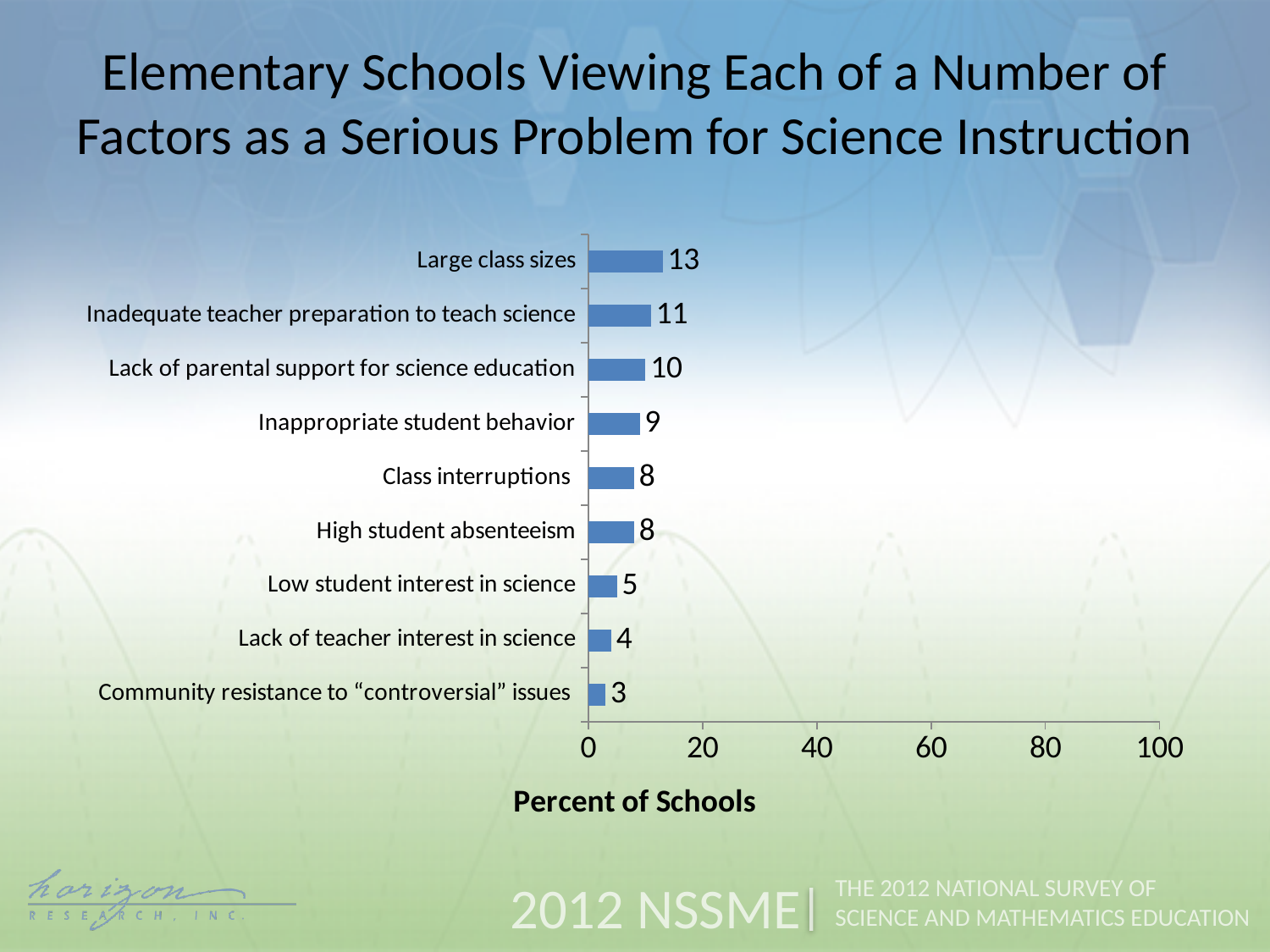
Which factor has the lowest percent of schools viewing it as a serious problem? Community resistance to "controversial" issues What is the value for 'Lack of teacher interest in science'? 4 What is the difference between the values for 'Large class sizes' and 'Lack of parental support for science education'? 3 What percent of schools view large class sizes as a serious problem for science instruction? 13 How many factors are shown in the chart? 9 Is the value for 'Large class sizes' greater or less than 20? less What is the value for 'Class interruptions'? 8 What kind of chart is shown on the slide? Bar chart What is the value for 'Inadequate teacher preparation to teach science'? 11 What is the label of the horizontal axis? Percent of Schools Which is larger: the value for 'Inappropriate student behavior' or the value for 'Low student interest in science'? Inappropriate student behavior Which factor has the highest percent of schools viewing it as a serious problem? Large class sizes